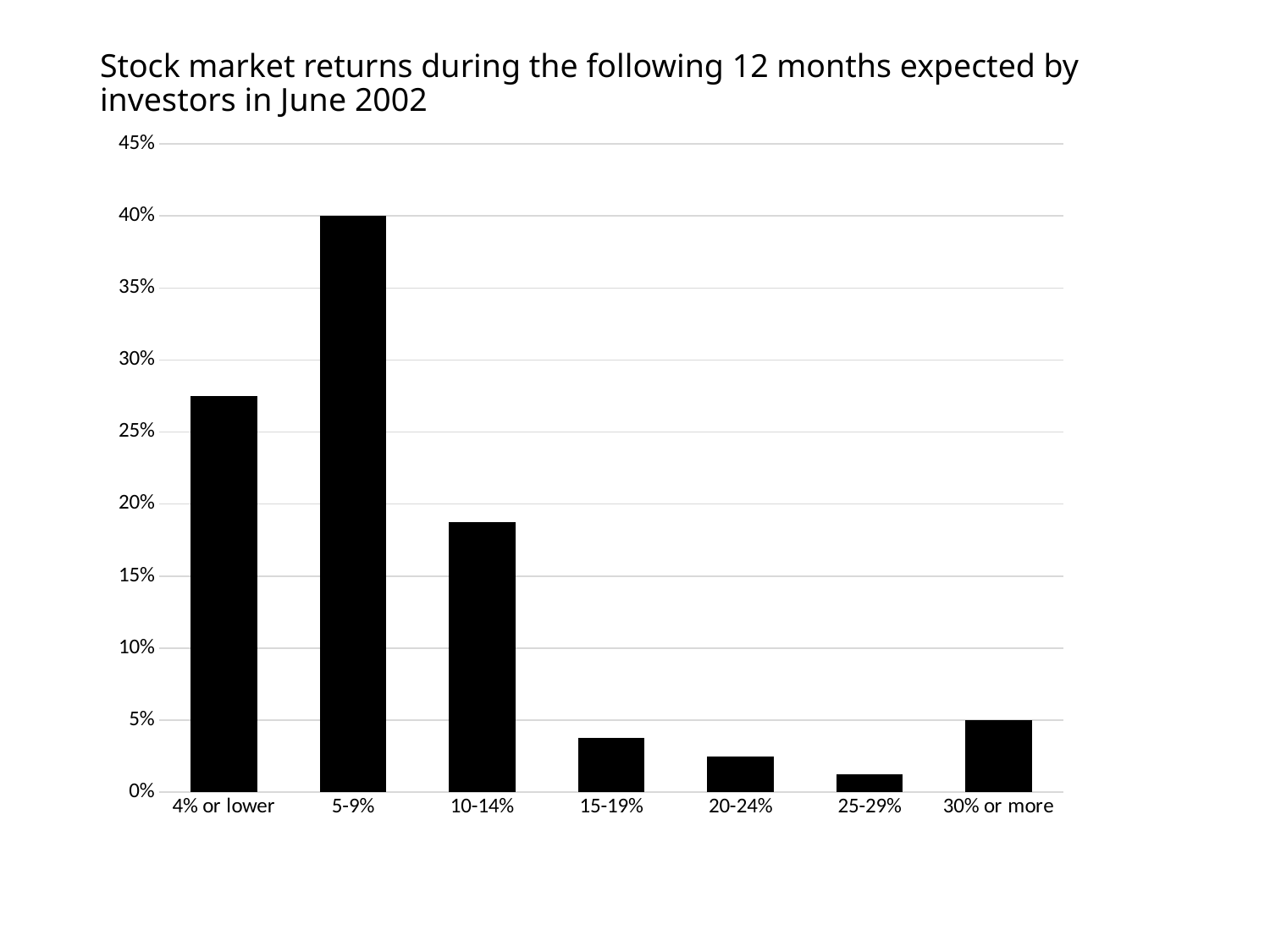
What share of investors expected returns of 5-9%? 40% What share of investors expected returns of 30% or more? 5% Which is larger, the value for '4% or lower' or the value for '10-14%'? 4% or lower What type of chart is shown on the slide? bar chart Is the value for '10-14%' greater or less than 20%? less Is the value for '15-19%' greater or less than 5%? less Which return category has the highest share of investors? 5-9% Which return category has the lowest share of investors? 25-29% Do the values rise or fall from the '5-9%' category to the '25-29%' category? fall How many return categories are shown on the x axis? 7 Is the value for '4% or lower' greater or less than 25%? greater What is the title of the chart? Stock market returns during the following 12 months expected by investors in June 2002